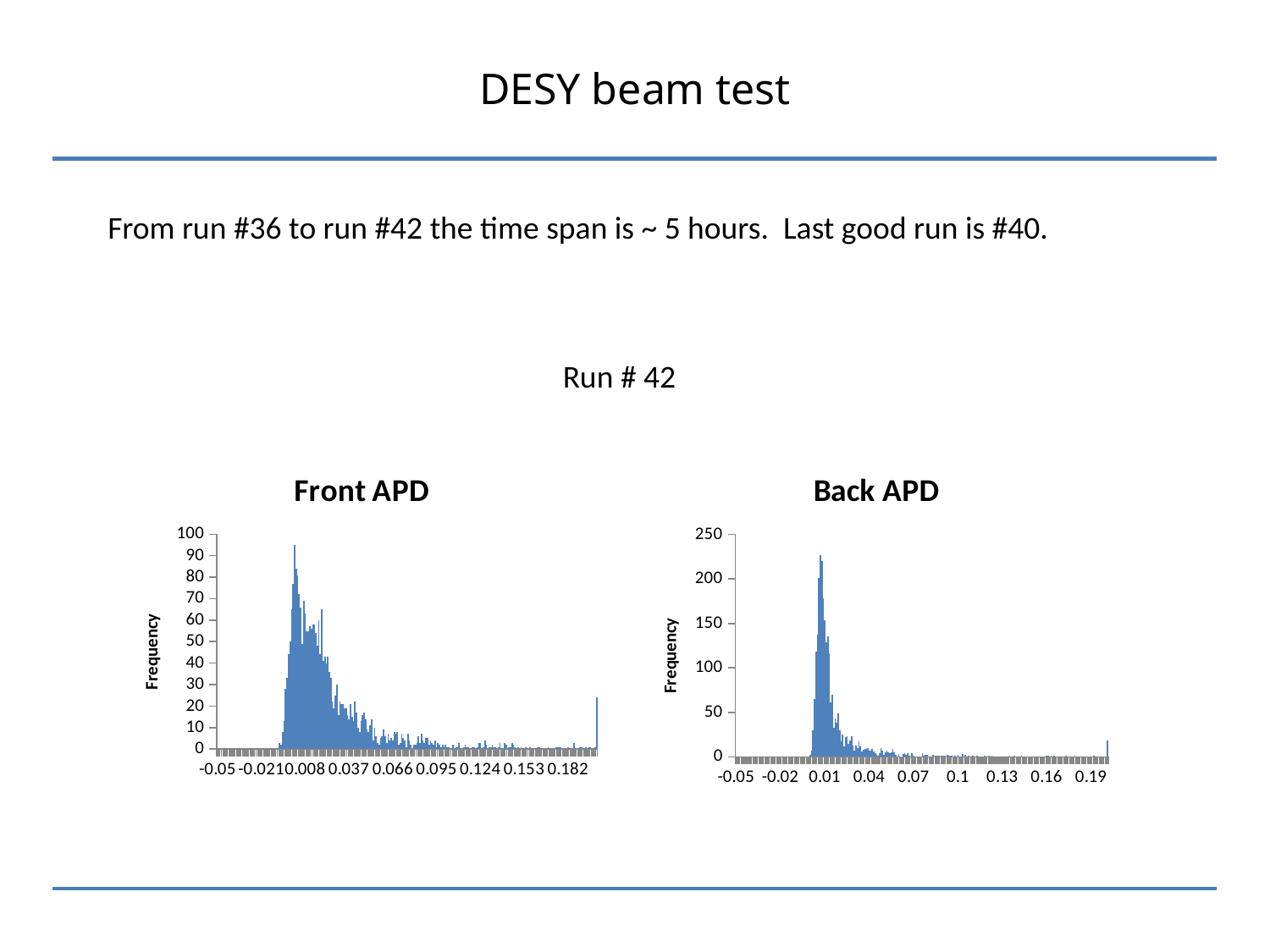
What kind of chart is the Back APD chart? bar chart In the Front APD chart, is the tallest bar greater or less than 80? greater In the Front APD chart, do the bar heights rise or fall as the x axis moves from 0.037 toward 0.153? fall What is the y-axis label of the Front APD chart? Frequency How many charts are shown on the slide? 2 In the Back APD chart, do the bar heights rise or fall as the x axis moves from 0.01 toward 0.19? fall In the Front APD chart, is the bar at the far right end of the x axis greater or less than 30? less In the Back APD chart, is the bar at the far right end of the x axis greater or less than 50? less What is the highest value shown on the y-axis of the Back APD chart? 250 Which chart has the taller peak bar, Front APD or Back APD? Back APD What kind of chart is the Front APD chart? bar chart